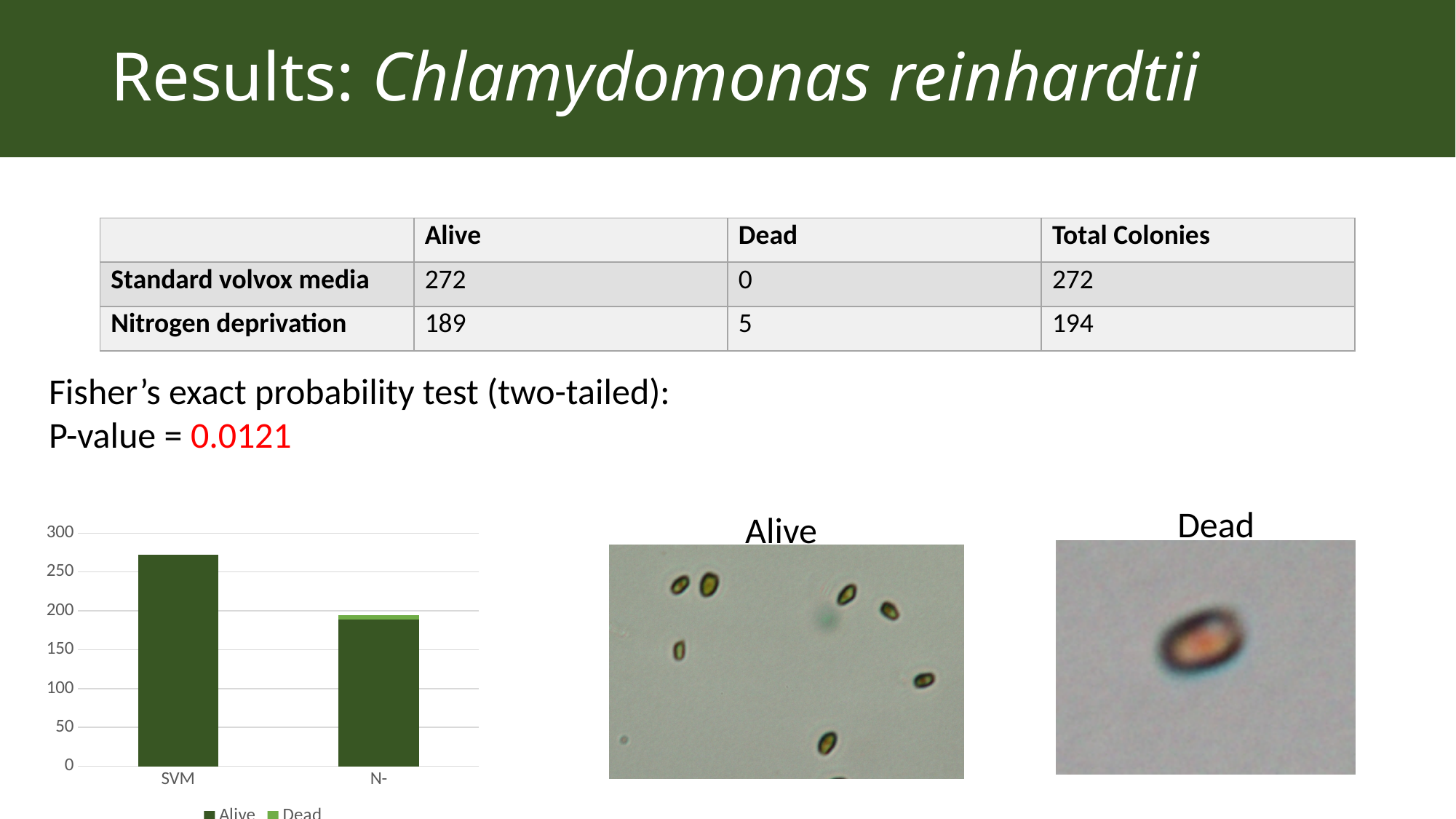
What are the category labels on the x axis of the bar chart? SVM and N- How many categories are shown on the x axis of the bar chart? 2 In the bar chart, is the Alive value for N- greater or less than 200? less What are the two series named in the legend of the bar chart? Alive and Dead In the bar chart, which category has the tallest bar? SVM What kind of chart is shown at the bottom left of the slide? Bar chart In the bar chart, do the bar heights rise or fall from SVM to N-? fall In the bar chart, which category has the larger Alive value, SVM or N-? SVM In the bar chart, is the total stacked value for N- greater or less than 150? greater In the bar chart, which category shows a visible Dead segment on top of its bar? N- How many series does the legend of the bar chart list? 2 In the bar chart, is the Alive value for SVM greater or less than 250? greater